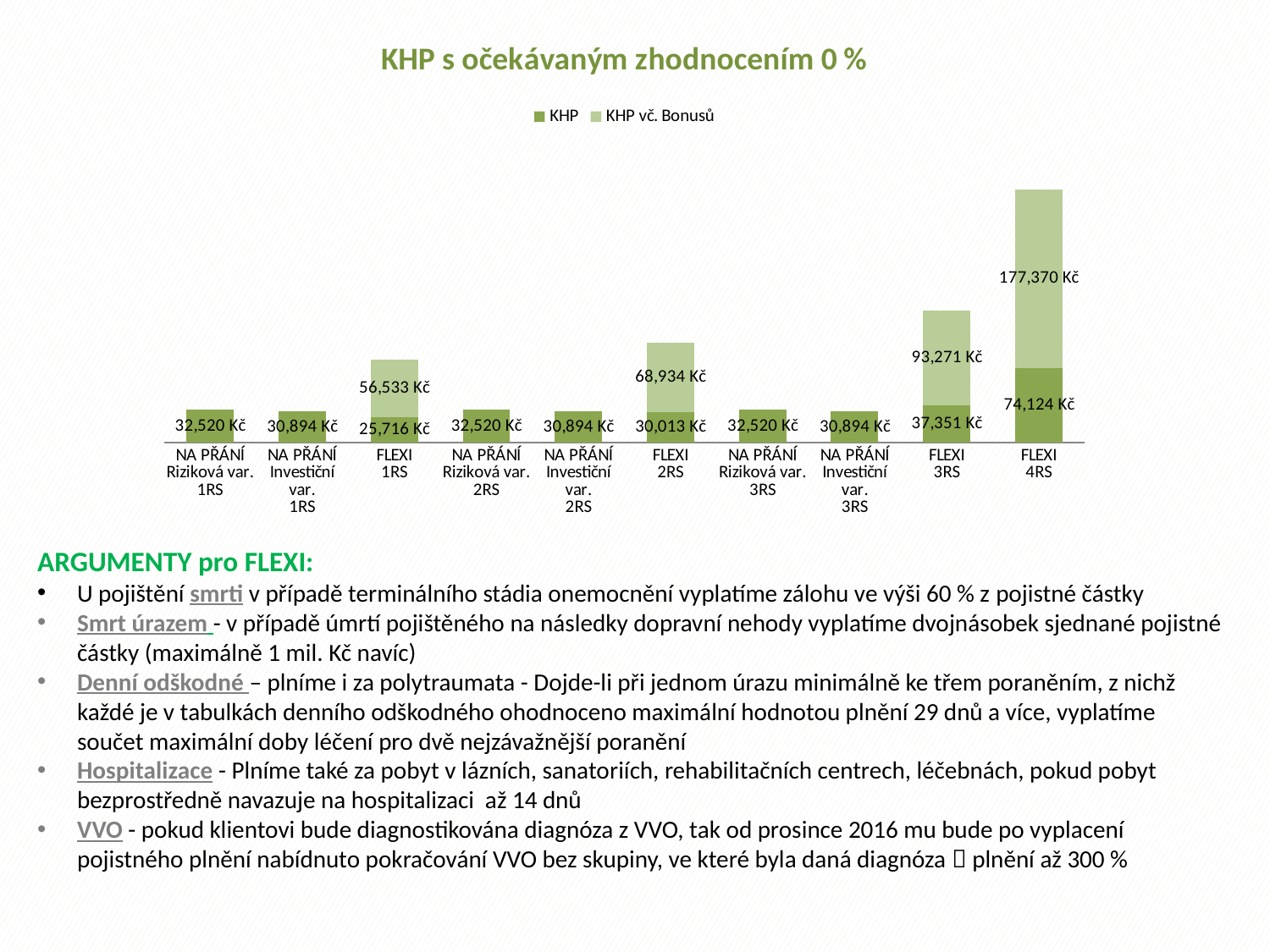
What is the KHP value for FLEXI 3RS? 37,351 Kč What is the difference between the KHP vč. Bonusů value and the KHP value for FLEXI 2RS? 38,921 Kč What is the KHP vč. Bonusů value for FLEXI 1RS? 56,533 Kč What is the KHP vč. Bonusů value for FLEXI 4RS? 177,370 Kč How many categories are shown on the x axis of the chart? 10 How many series does the chart legend list? 2 What is the title of the chart? KHP s očekávaným zhodnocením 0 % What is the value shown for NA PŘÁNÍ Investiční var. 2RS? 30,894 Kč What kind of chart is shown on the slide? bar chart Which is larger: the KHP value for FLEXI 1RS or the value for NA PŘÁNÍ Riziková var. 1RS? NA PŘÁNÍ Riziková var. 1RS Which category has the highest KHP vč. Bonusů value? FLEXI 4RS What is the KHP value for FLEXI 4RS? 74,124 Kč